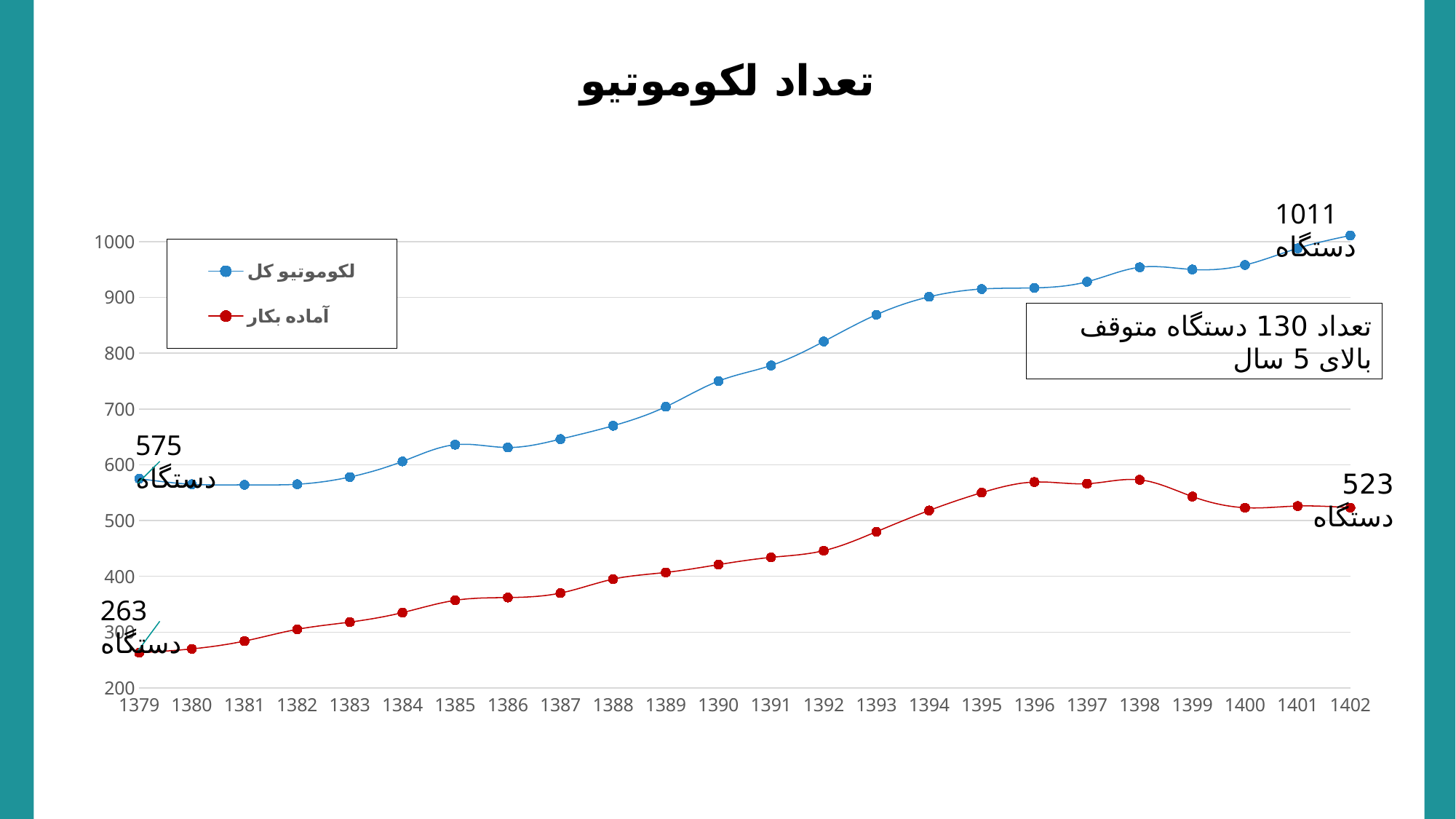
Does لکوموتیو کل generally rise or fall from 1379 to 1402? rise What is the value of آماده بکار in 1402? 523 دستگاه What is the value of آماده بکار in 1379? 263 دستگاه How many series does the legend list? 2 By how much did لکوموتیو کل increase from 1379 to 1402? 436 What type of chart is shown on the slide? line chart How many years are shown on the x axis? 24 Is the value for لکوموتیو کل in 1390 greater or less than 700? greater What is the difference between لکوموتیو کل and آماده بکار in 1402? 488 What is the value of لکوموتیو کل in 1379? 575 دستگاه What is the value of لکوموتیو کل in 1402? 1011 دستگاه In which year is آماده بکار at its lowest? 1379